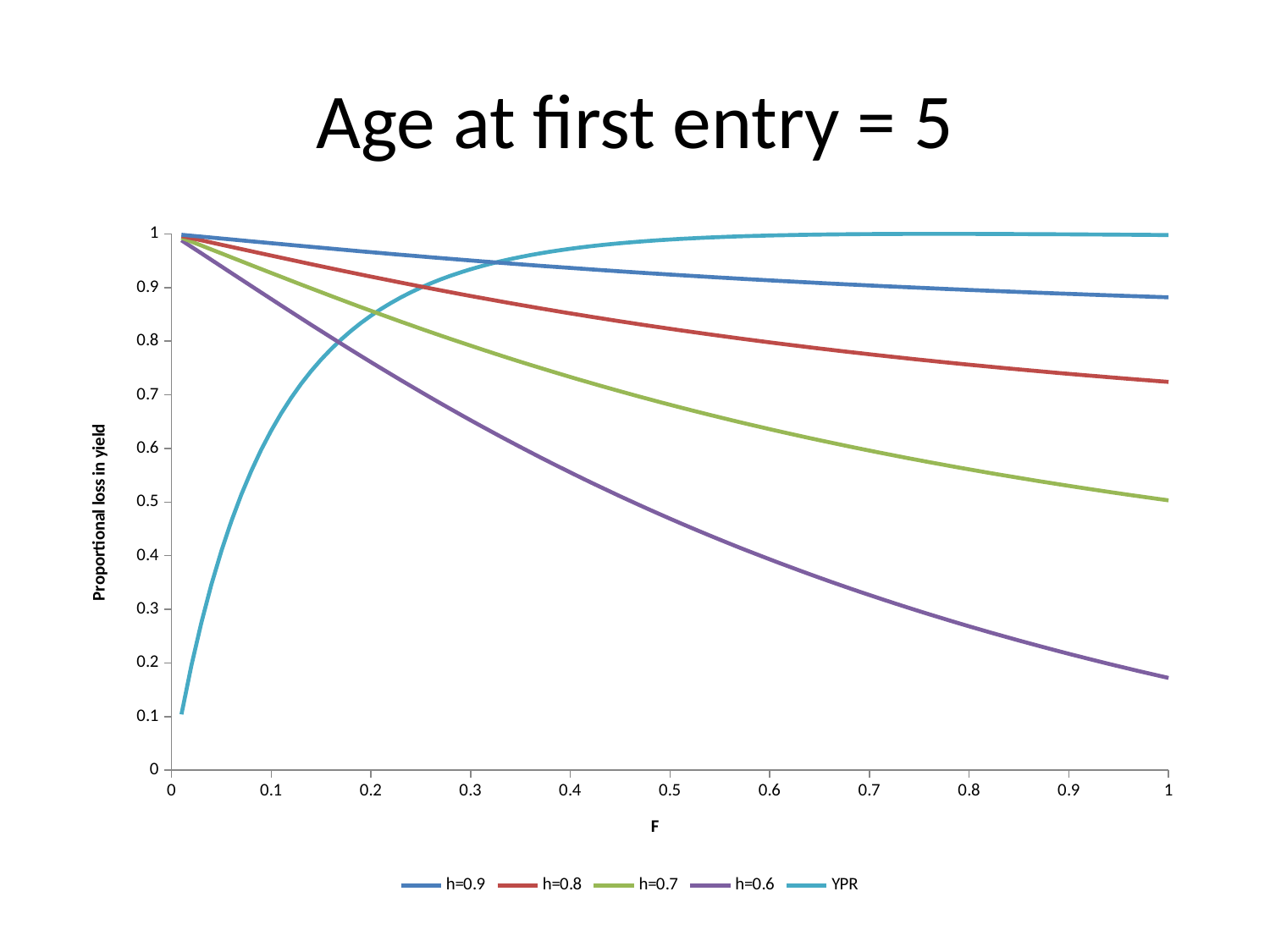
Is the value of the h=0.9 line at F = 1 greater or less than 0.8? greater Does the YPR line rise or fall as F increases? rise Is the value of the h=0.7 line at F = 1 greater or less than 0.6? less Does the h=0.6 line rise or fall as F increases? fall Which series has the highest value at F = 1? YPR How many series does the legend list? 5 Which series has the lowest value at F = 1? h=0.6 What is the label of the y axis? Proportional loss in yield What kind of chart is shown on the slide? line chart Is the value of the h=0.6 line at F = 1 greater or less than 0.2? less At F = 1, which is larger: the h=0.8 line or the h=0.7 line? h=0.8